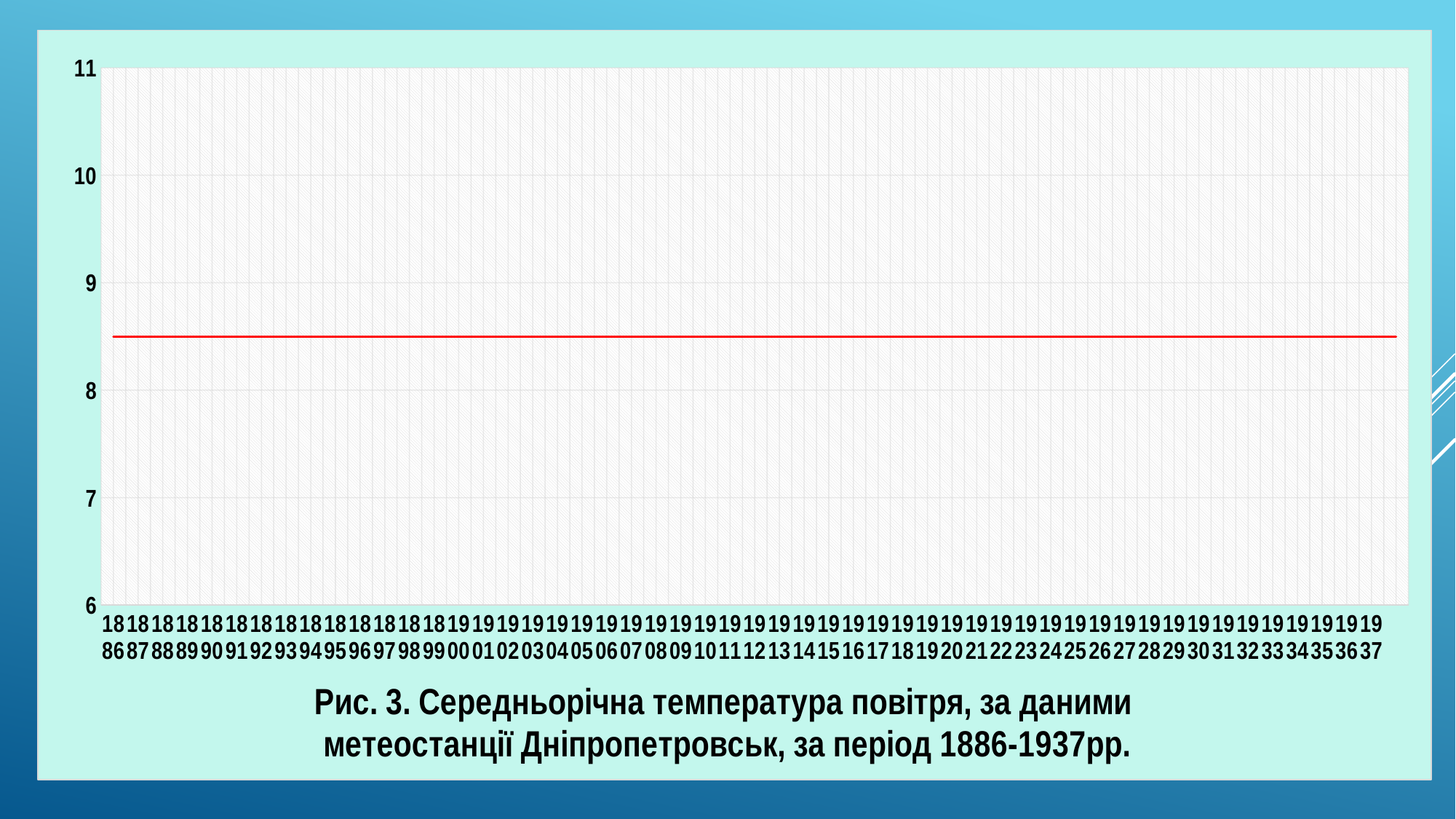
What kind of chart is shown on the slide? line chart Is the value for 1937 greater or less than 9? less How many years are shown on the x axis? 52 Is the value for 1886 greater or less than 8? greater What is the highest value shown on the y axis? 11 What is the first year shown on the x axis? 1886 Do the plotted values rise, fall, or stay flat from 1886 to 1937? stay flat Is the value for 1900 greater or less than 7? greater What is the last year shown on the x axis? 1937